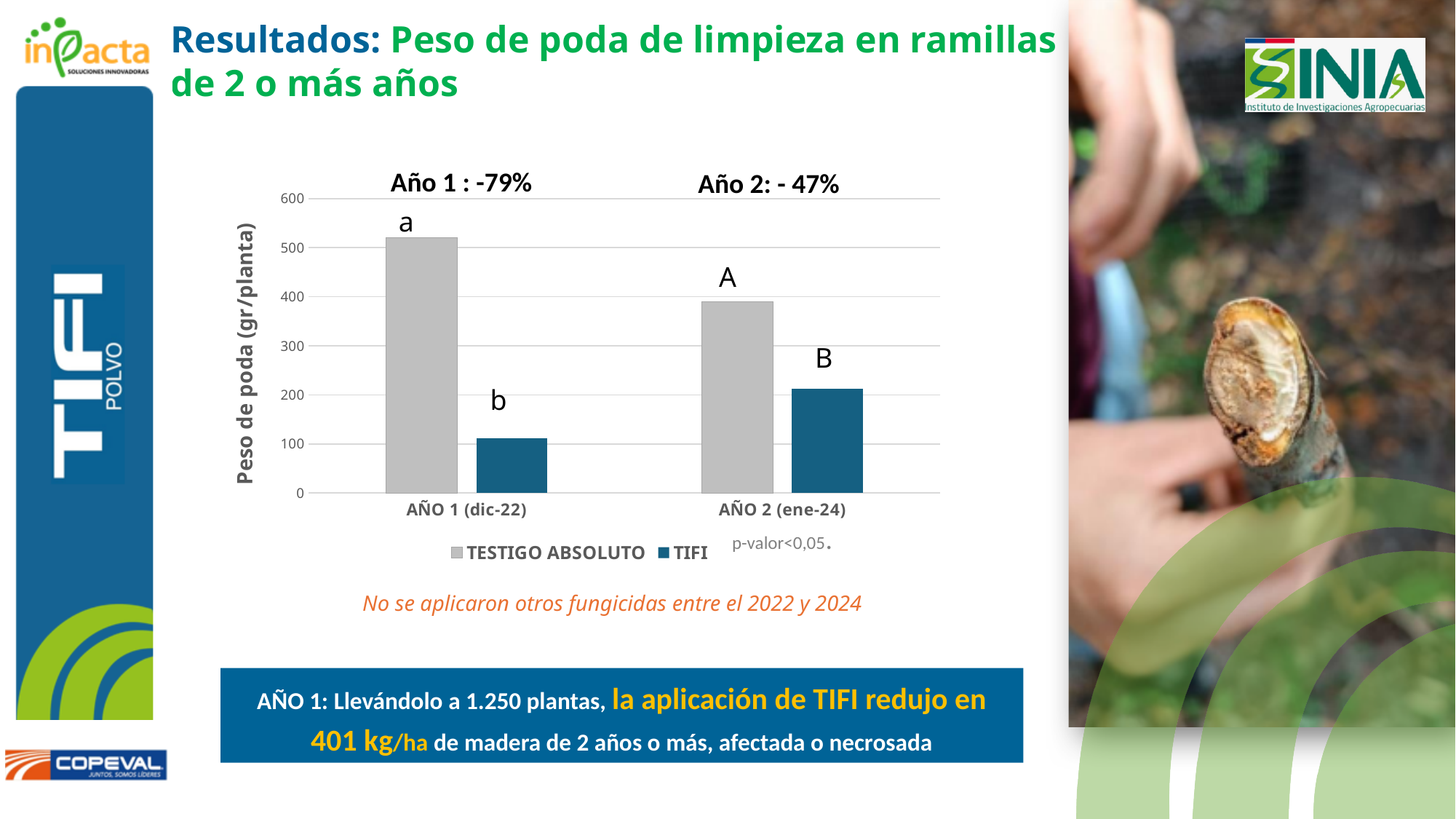
Which bar in the chart is the tallest? TESTIGO ABSOLUTO in AÑO 1 (dic-22) How many series does the chart legend list? 2 Is the value for TIFI in AÑO 1 (dic-22) greater or less than 200? less Which series has the higher value in AÑO 2 (ene-24), TESTIGO ABSOLUTO or TIFI? TESTIGO ABSOLUTO How many categories are shown on the x axis of the chart? 2 Is the value for TIFI in AÑO 2 (ene-24) greater or less than 300? less Is the value for TESTIGO ABSOLUTO in AÑO 2 (ene-24) greater or less than 300? greater What is the label of the y axis of the chart? Peso de poda (gr/planta) Which bar in the chart is the shortest? TIFI in AÑO 1 (dic-22) What kind of chart is shown on the slide? bar chart What percentage reduction is annotated above the AÑO 1 bars in the chart? -79%